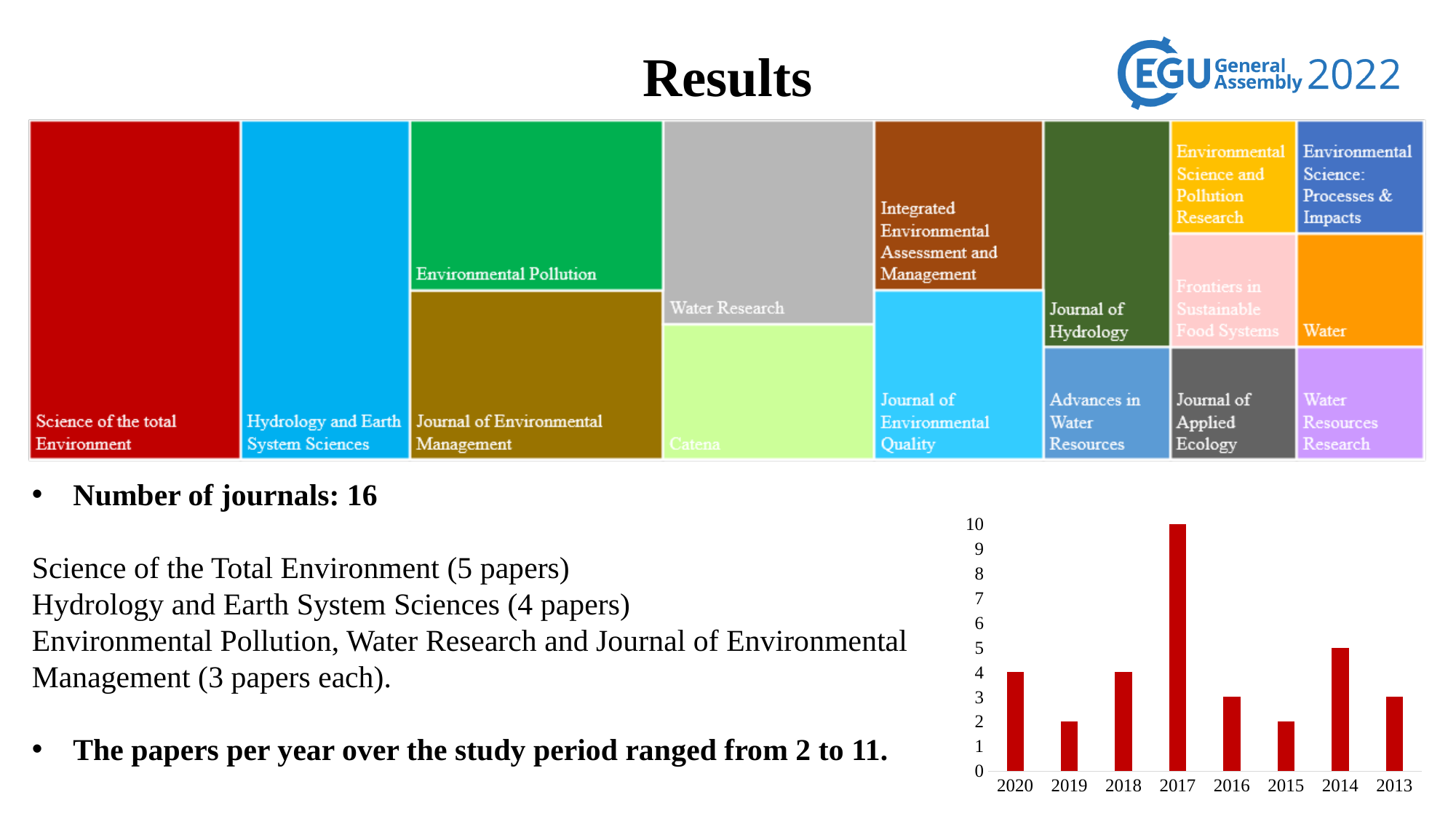
How many journals are shown in the treemap at the top of the slide? 16 In the bar chart at the bottom right, what is the difference between the values for 2014 and 2013? 2 In the treemap at the top of the slide, what colour is the block for Water Research? grey In the bar chart at the bottom right, what is the value for 2020? 4 In the bar chart at the bottom right, is the value for 2017 greater or less than 8? greater What kind of chart is the chart at the bottom right of the slide? bar chart In the bar chart at the bottom right, what is the value for 2014? 5 In the treemap at the top of the slide, which journal occupies the largest area? Science of the total Environment In the bar chart at the bottom right, which year has the highest value? 2017 In the bar chart at the bottom right, how many years are shown on the x axis? 8 In the bar chart at the bottom right, what is the value for 2019? 2 In the bar chart at the bottom right, which is larger, the value for 2018 or the value for 2016? 2018